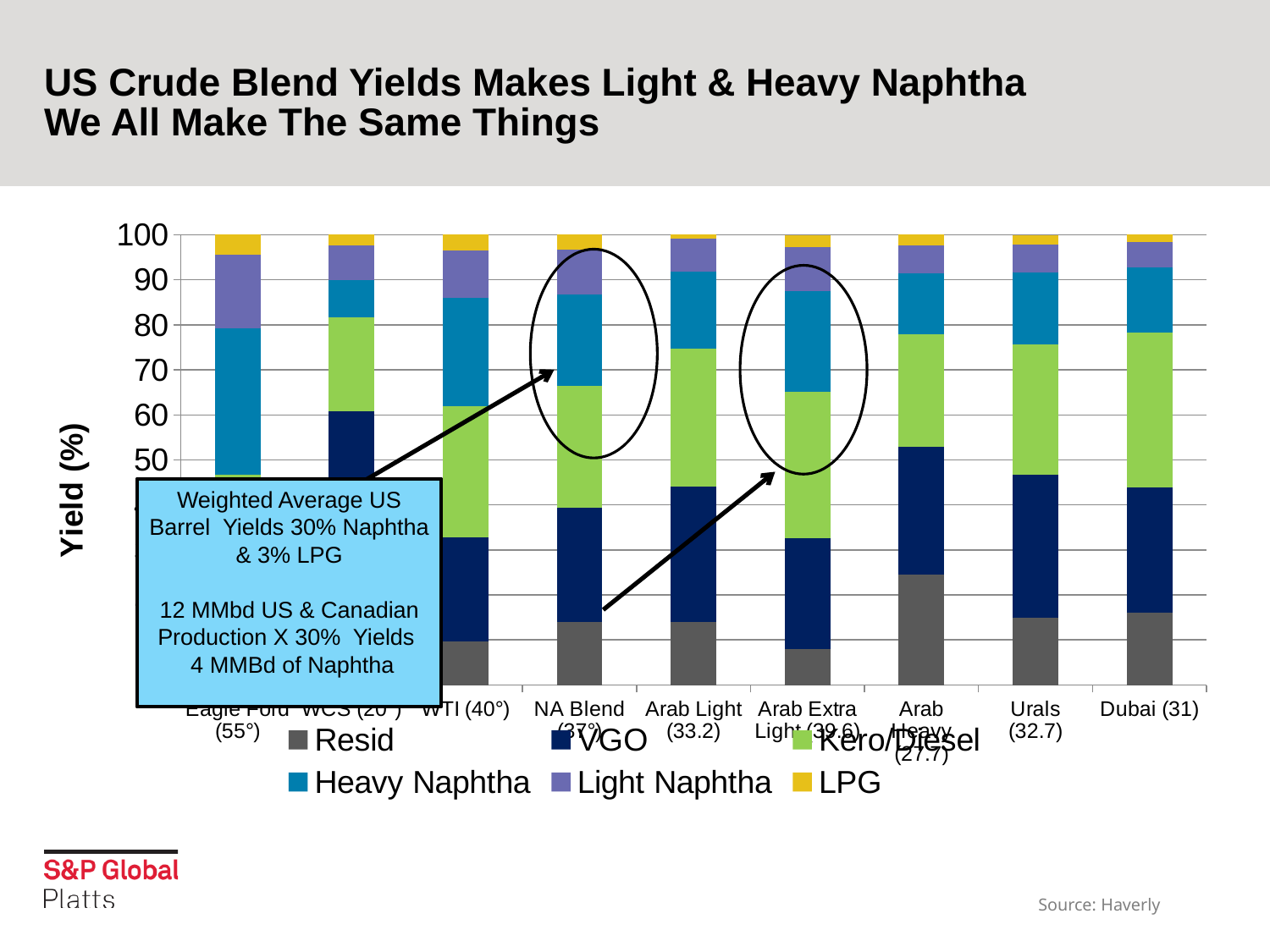
Is the cumulative yield at the top of the VGO segment for Arab Heavy (27.7) greater or less than 50? greater What type of chart is shown on the slide? Stacked bar chart Which crude has the largest Heavy Naphtha segment? Eagle Ford (55°) Is the cumulative yield at the top of the Kero/Diesel segment for Arab Light (33.2) greater or less than 70? greater How many crude categories are plotted along the x axis? 9 Which crude has the largest Light Naphtha segment? Eagle Ford (55°) What is the label of the y axis? Yield (%) Which series is shown in yellow at the top of each stacked bar? LPG Is the cumulative yield at the top of the Heavy Naphtha segment for Eagle Ford (55°) greater or less than 70? greater Which has the larger Heavy Naphtha segment, Eagle Ford (55°) or Dubai (31)? Eagle Ford (55°) How many series does the chart legend list? 6